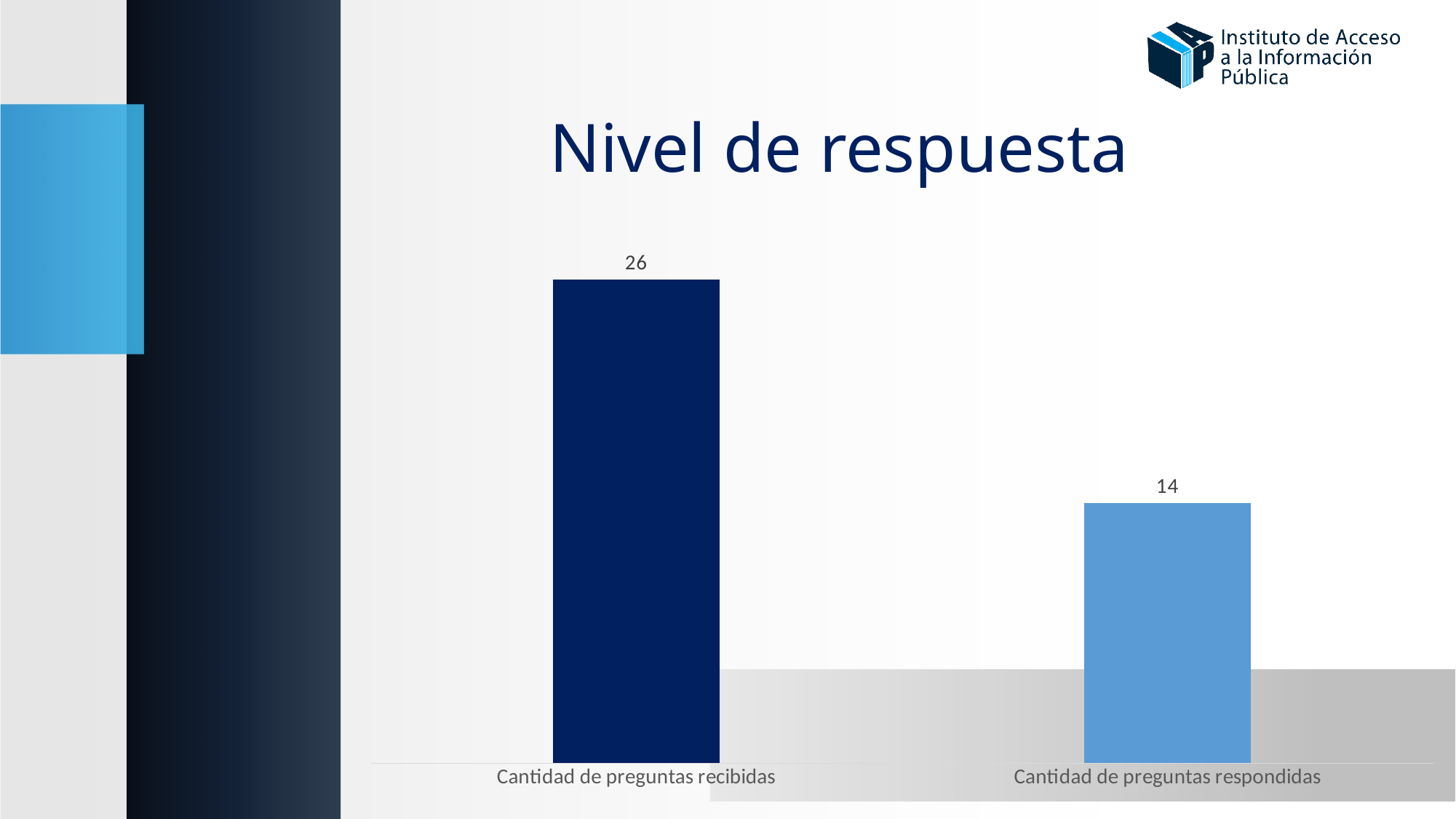
What is the value for "Cantidad de preguntas recibidas"? 26 Which category has the lowest value? Cantidad de preguntas respondidas What kind of chart is shown on the slide? Bar chart What is the difference between the value for "Cantidad de preguntas recibidas" and the value for "Cantidad de preguntas respondidas"? 12 How many categories are shown in the chart? 2 What is the value for "Cantidad de preguntas respondidas"? 14 Which is larger: the value for "Cantidad de preguntas recibidas" or the value for "Cantidad de preguntas respondidas"? Cantidad de preguntas recibidas Which category has the highest value? Cantidad de preguntas recibidas What colour is the bar for "Cantidad de preguntas respondidas"? Light blue What is the title of the slide containing the chart? Nivel de respuesta